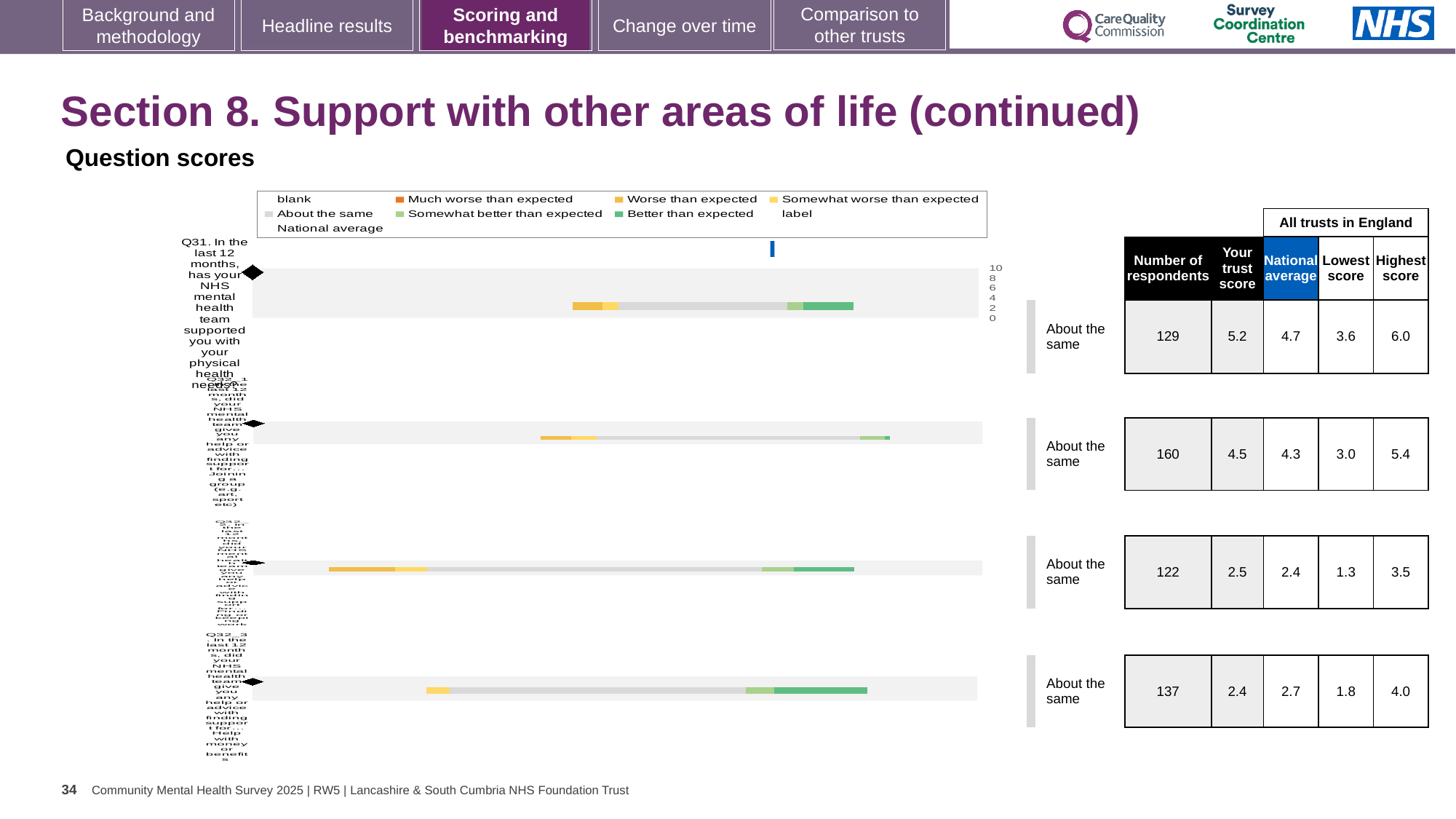
Which of the four questions has the highest number of respondents? the second question (160 respondents) What is the trust score for Q31 (support with your physical health needs)? 5.2 What kind of chart is used to show the question scores on this slide? bar chart How many questions (bars) are plotted in the question scores chart? 4 What benchmark category is shown for Q31 (support with your physical health needs)? About the same What is the highest score among all trusts in England for Q31 (support with your physical health needs)? 6.0 What is the lowest score among all trusts in England for the third question (trust score 2.5)? 1.3 For the fourth question (help with money or benefits), which is larger: the trust score or the national average? the national average (2.7) What is the number of respondents for Q31 (support with your physical health needs)? 129 What is the national average for Q31 (support with your physical health needs)? 4.7 What is the maximum value shown on the chart's score axis? 10 What is the difference between the trust score and the national average for Q31 (support with your physical health needs)? 0.5